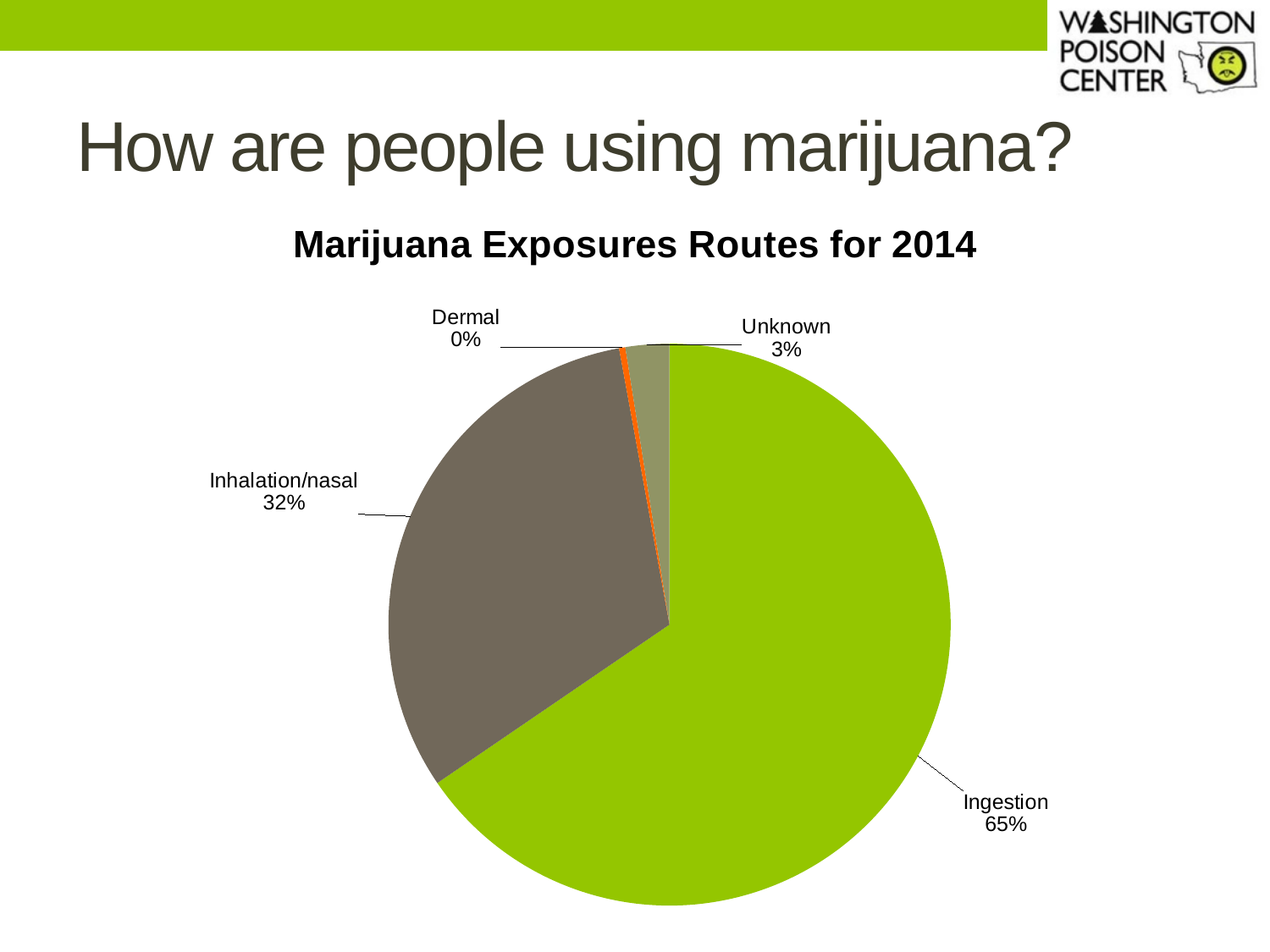
How many percentage points larger is the ingestion share than the inhalation/nasal share? 33 What percentage is shown for the dermal route? 0% What kind of chart is shown on the slide? Pie chart What share of marijuana exposures in 2014 was by ingestion? 65% How many exposure routes are shown in the pie chart? 4 Which exposure route has the largest share of the pie? Ingestion What colour is the ingestion slice of the pie? Green Which exposure route has the smallest share of the pie? Dermal What percentage of exposures had an unknown route? 3% Which is larger, the share for inhalation/nasal or the share for unknown? Inhalation/nasal What percentage of exposures was by inhalation/nasal route? 32% What is the title of the chart? Marijuana Exposures Routes for 2014